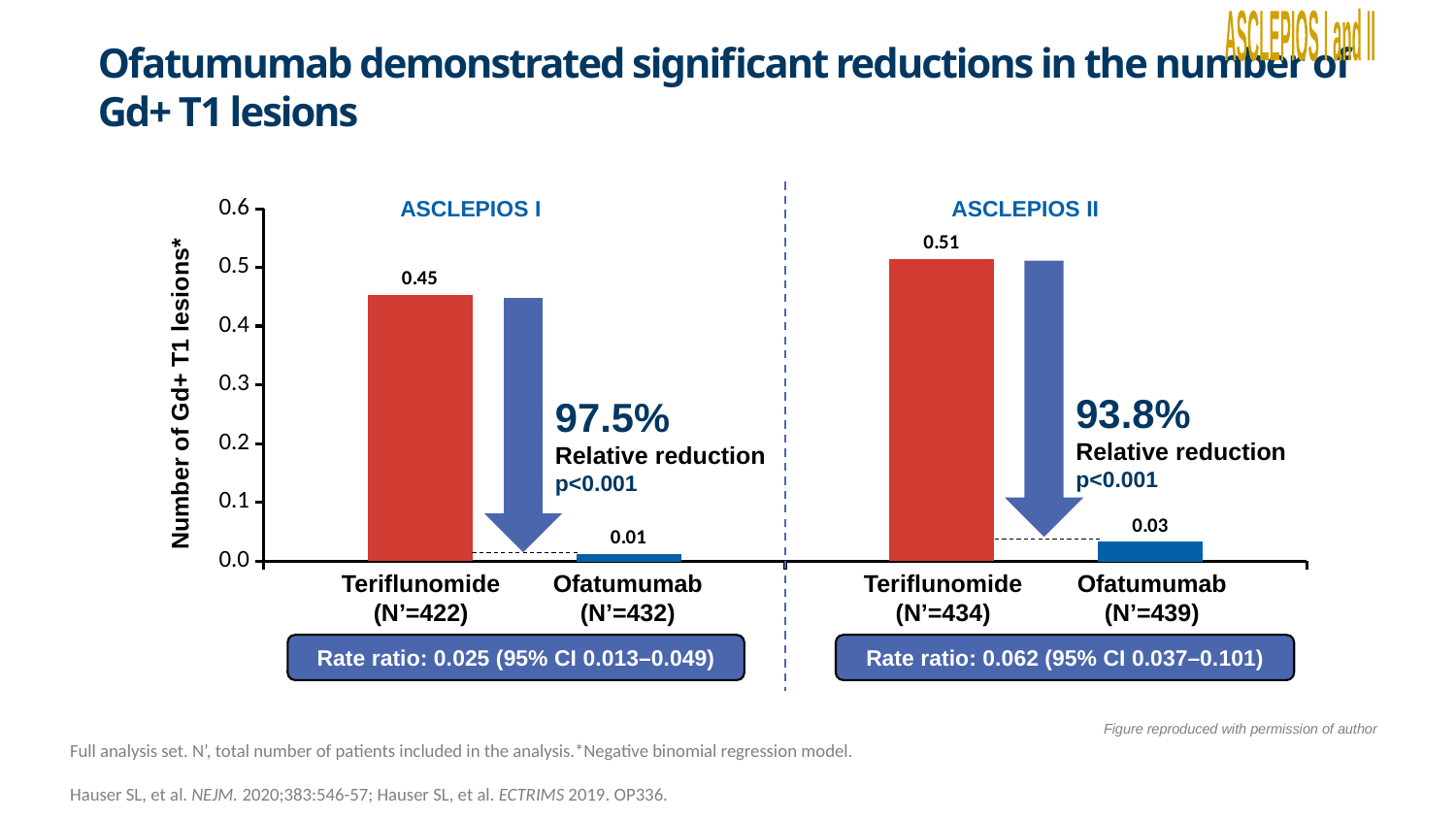
In the ASCLEPIOS II panel, what is the difference in the number of Gd+ T1 lesions between Teriflunomide and Ofatumumab? 0.48 In the ASCLEPIOS I panel, what is the number of Gd+ T1 lesions for Teriflunomide? 0.45 Which has a higher number of Gd+ T1 lesions: Teriflunomide in ASCLEPIOS I or Teriflunomide in ASCLEPIOS II? Teriflunomide in ASCLEPIOS II What rate ratio is shown for the ASCLEPIOS II panel? 0.062 (95% CI 0.037–0.101) Across both panels, which bar shows the highest number of Gd+ T1 lesions? Teriflunomide in ASCLEPIOS II In the ASCLEPIOS I panel, what is the difference in the number of Gd+ T1 lesions between Teriflunomide and Ofatumumab? 0.44 What relative reduction is shown for the ASCLEPIOS I panel? 97.5% In the ASCLEPIOS II panel, what is the number of Gd+ T1 lesions for Ofatumumab? 0.03 What type of chart is shown on the slide? Bar chart Across both panels, which bar shows the lowest number of Gd+ T1 lesions? Ofatumumab in ASCLEPIOS I In the ASCLEPIOS II panel, what is the number of Gd+ T1 lesions for Teriflunomide? 0.51 In the ASCLEPIOS I panel, what is the number of Gd+ T1 lesions for Ofatumumab? 0.01